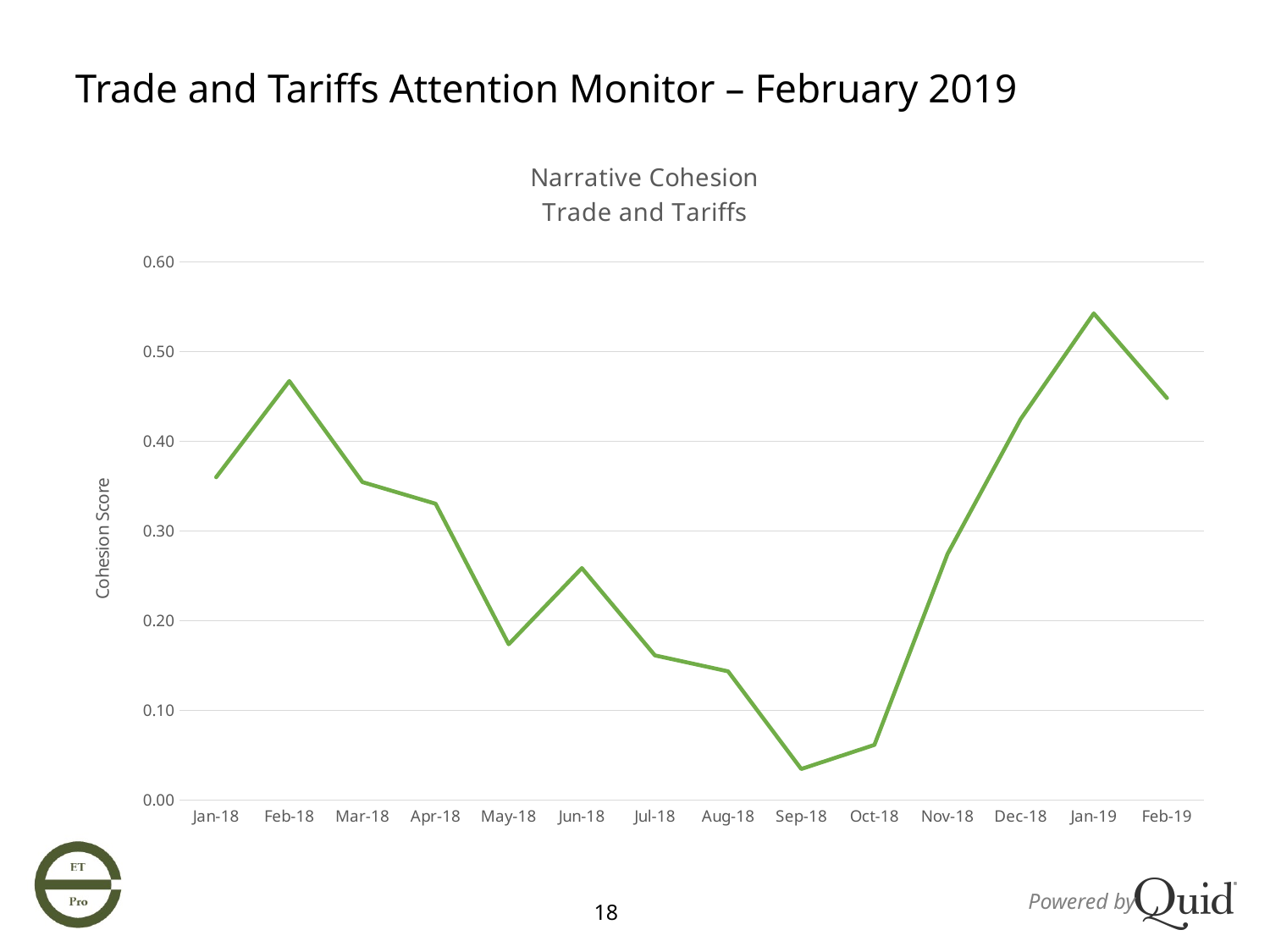
Is the cohesion score for Feb-18 greater or less than 0.40? greater Is the cohesion score for May-18 greater or less than 0.20? less Is the cohesion score for Jan-19 greater or less than 0.50? greater Which has the higher cohesion score, Jun-18 or Aug-18? Jun-18 Which has the higher cohesion score, Feb-18 or Jan-19? Jan-19 How many months are plotted along the x axis of the chart? 14 Which month has the highest cohesion score? Jan-19 What is the label on the y axis of the chart? Cohesion Score What kind of chart is shown on the slide? line chart Which month has the lowest cohesion score? Sep-18 Does the cohesion score rise or fall from Sep-18 to Jan-19? rise